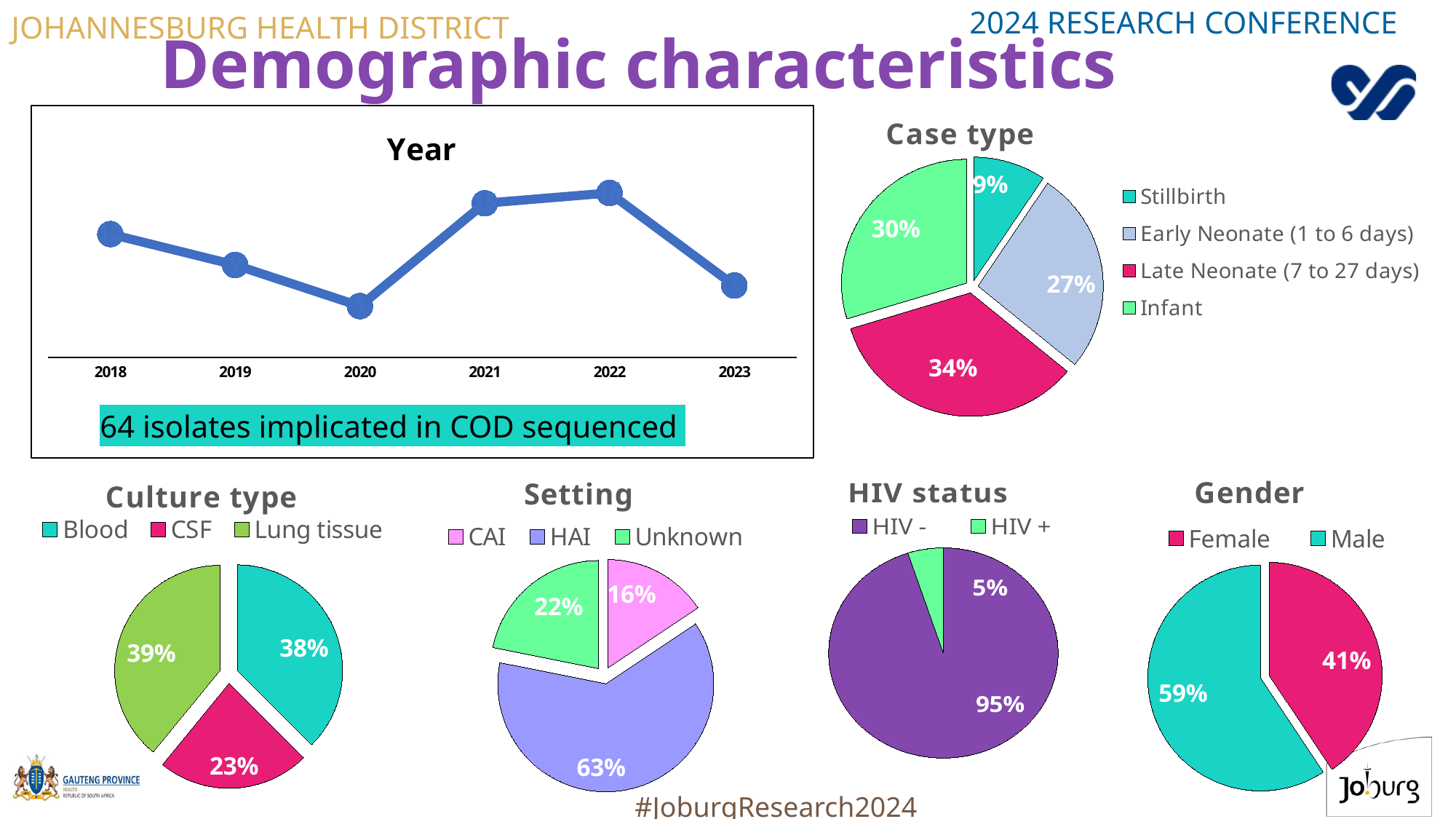
In the Case type pie chart, how many categories does the legend list? 4 In the Setting pie chart, what share is Unknown? 22% In the Case type pie chart, what share is Late Neonate (7 to 27 days)? 34% In the Case type pie chart, what is the difference in percentage points between Late Neonate (7 to 27 days) and Stillbirth? 25 percentage points In the HIV status pie chart, what share is HIV +? 5% In the Culture type pie chart, which category has the smallest share? CSF In the Year chart at the top left, which year has the lowest value? 2020 In the Setting pie chart, which category has the largest share? HAI In the Year chart at the top left, how many years are plotted? 6 In the Gender pie chart, which is larger, Female or Male? Male In the Case type pie chart, which category has the smallest share? Stillbirth